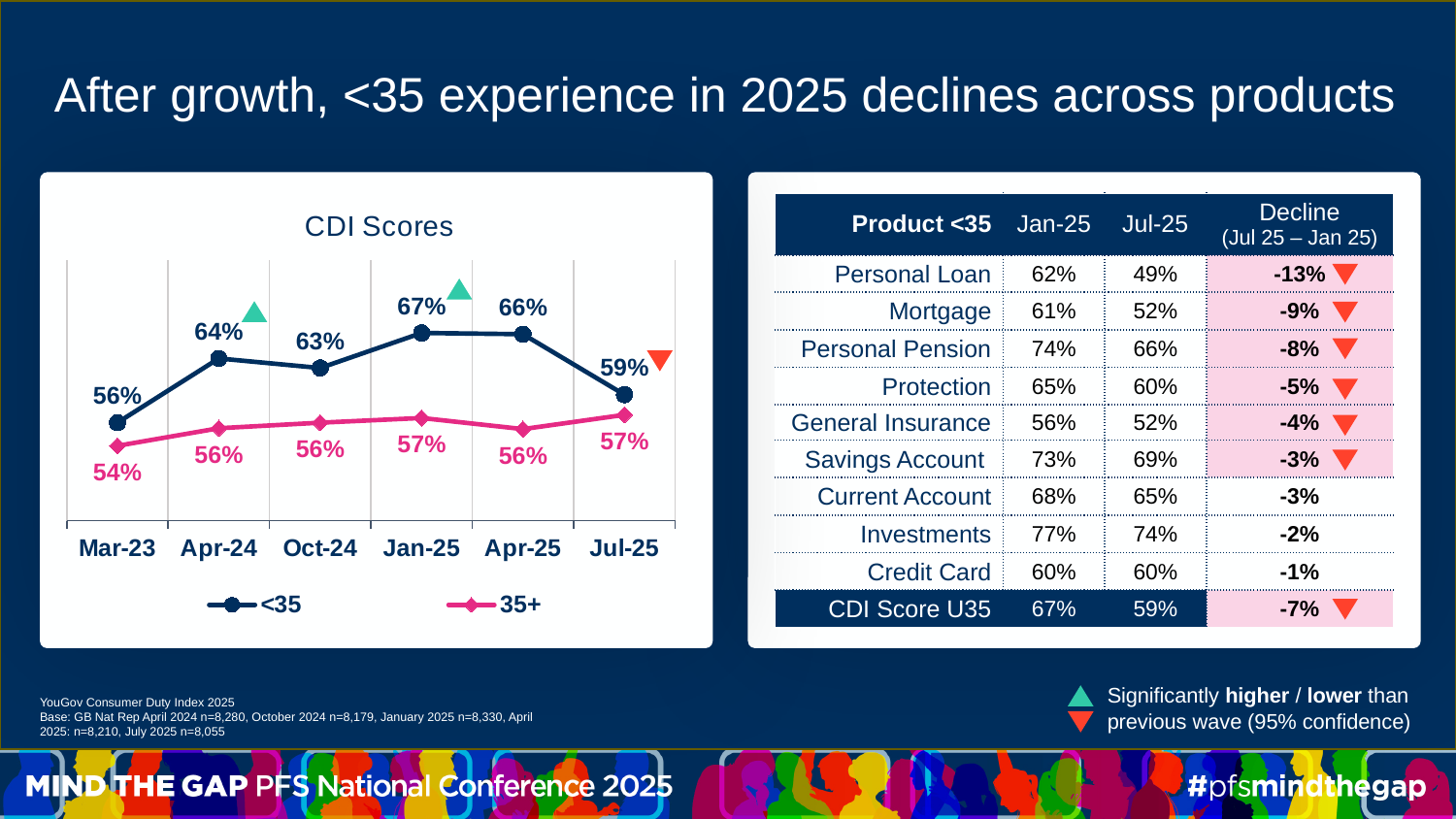
In the CDI Scores chart, at which date is the <35 series highest? Jan-25 What is the title of the chart on the left of the slide? CDI Scores In the CDI Scores chart, does the <35 series rise or fall from Jan-25 to Jul-25? Fall In the CDI Scores chart, at which date is the <35 series lowest? Mar-23 In the CDI Scores chart, which series has the higher value in Apr-25, <35 or 35+? <35 How many dates are shown on the x axis of the CDI Scores chart? 6 In the CDI Scores chart, what is the value for 35+ in Mar-23? 54% In the CDI Scores chart, what is the value for <35 in Jul-25? 59% What kind of chart is the CDI Scores chart? Line chart In the CDI Scores chart, what is the difference between the <35 and 35+ values in Jan-25? 10% In the CDI Scores chart, what is the value for <35 in Jan-25? 67% How many series does the legend of the CDI Scores chart list? 2